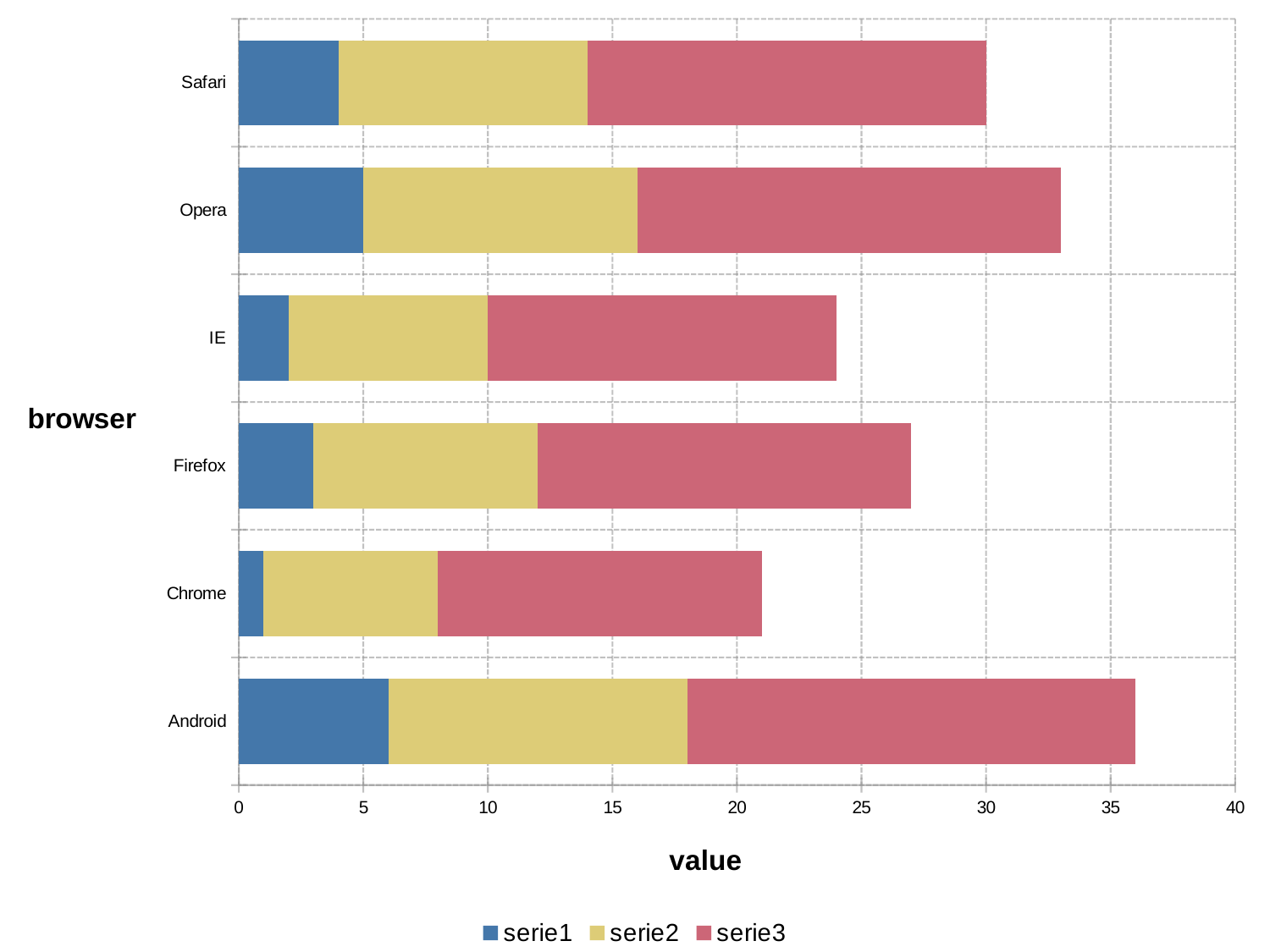
Is the total value for Firefox greater or less than 25? greater Is the total value for IE greater or less than 25? less What kind of chart is shown on the slide? stacked bar chart Which has the larger total bar, Opera or Safari? Opera Which browser has the longest total bar? Android How many series does the legend list? 3 What is the total value of the Safari bar? 30 What is the title of the horizontal axis? value Is the total value for Android greater or less than 35? greater What is the serie1 value for Opera? 5 How many browsers are listed on the vertical axis? 6 Which browser has the shortest total bar? Chrome